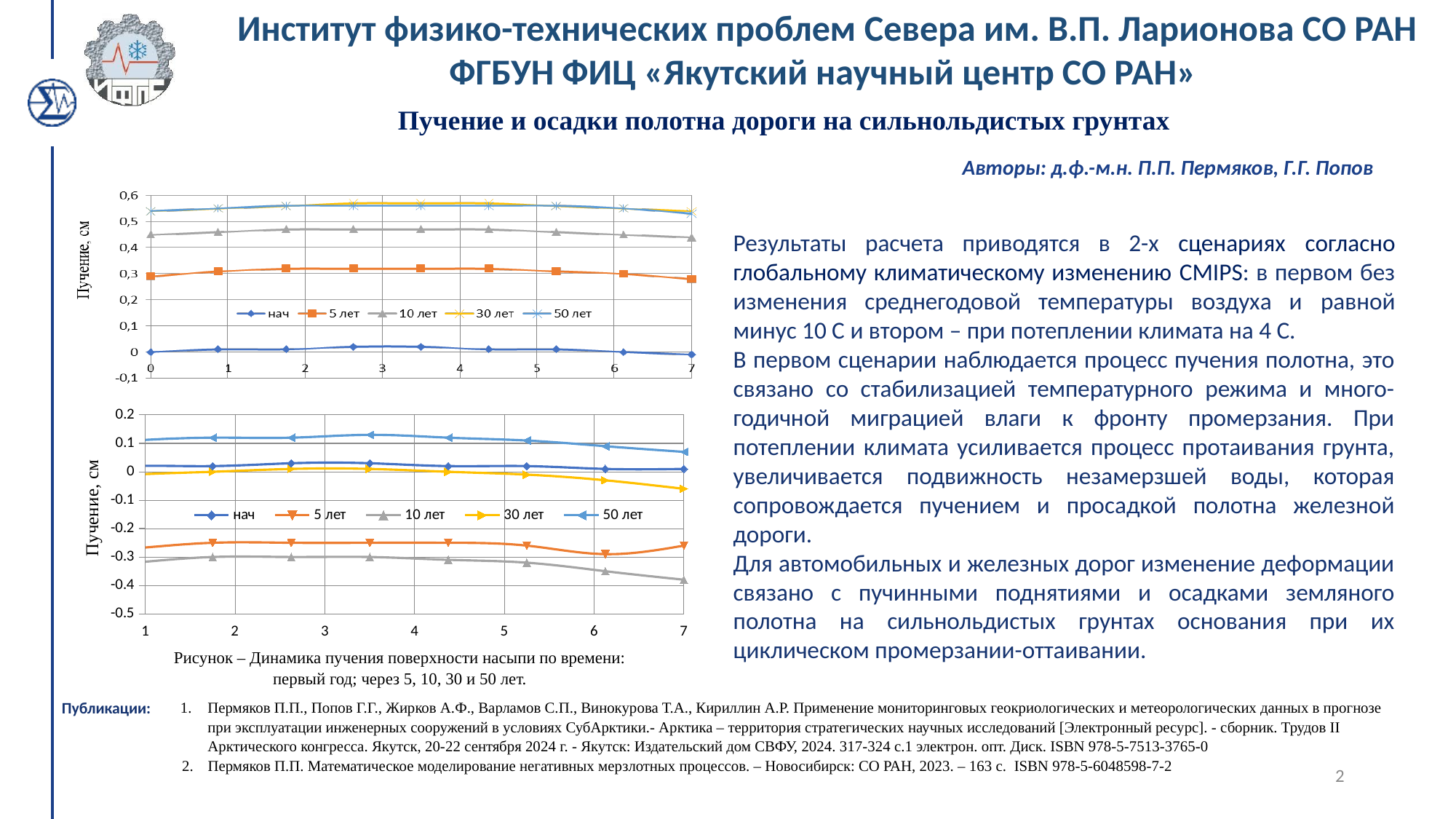
In the bottom chart, does the 30 лет series rise or fall from x = 4 to x = 7? fall What kind of chart is the top chart on the slide? line chart In the top chart, is the value of the 10 лет series at x = 4 greater or less than 0.4? greater In the bottom chart, which series has the highest values? 50 лет In the bottom chart, is the value of the 10 лет series at x = 7 greater or less than -0.3? less In the bottom chart, which series has the lowest values? 10 лет What is the label of the vertical axis of the bottom chart? Пучение, см In the top chart, which series has the lowest values? нач In the top chart, is the value of the 5 лет series at x = 4 greater or less than 0.2? greater In the bottom chart, which series is higher at x = 4: 5 лет or 10 лет? 5 лет How many series does the legend of the bottom chart list? 5